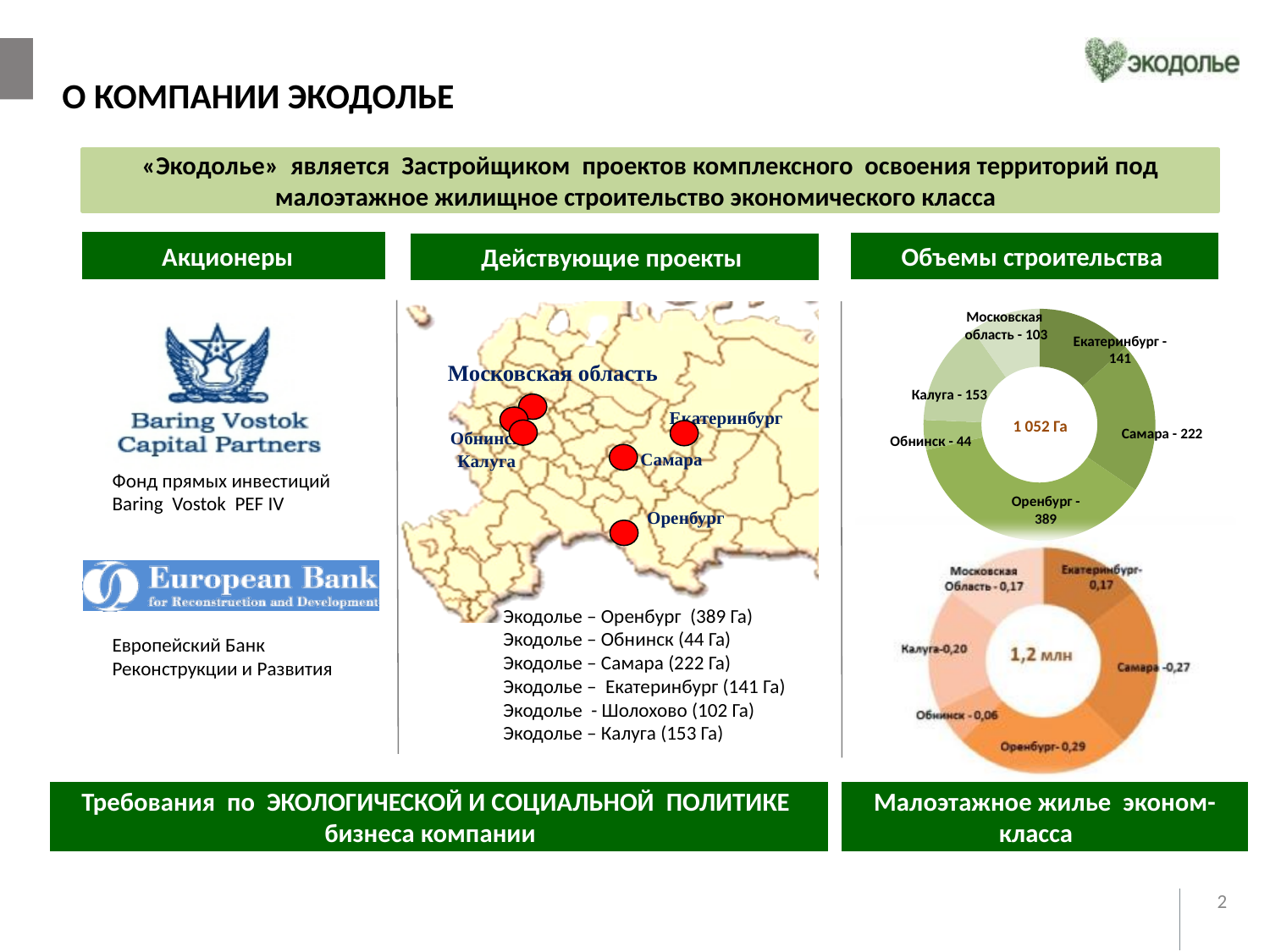
In the bottom orange donut chart under «Объемы строительства», what is the value for Обнинск? 0,06 How many categories are shown in the top green donut chart under «Объемы строительства»? 6 In the top green donut chart under «Объемы строительства», what is the value for Самара? 222 In the top green donut chart under «Объемы строительства», which category has the smallest value? Обнинск In the bottom orange donut chart under «Объемы строительства», what total is shown in the centre of the ring? 1,2 млн In the top green donut chart under «Объемы строительства», which category has the largest value? Оренбург What type of chart is the top green chart under «Объемы строительства»? Donut (pie) chart In the bottom orange donut chart under «Объемы строительства», which is larger: Самара or Калуга? Самара In the top green donut chart under «Объемы строительства», what is the difference between the values for Калуга and Екатеринбург? 12 In the bottom orange donut chart under «Объемы строительства», what is the value for Оренбург? 0,29 In the top green donut chart under «Объемы строительства», what is the value for Оренбург? 389 In the top green donut chart under «Объемы строительства», what total is shown in the centre of the ring? 1 052 Га